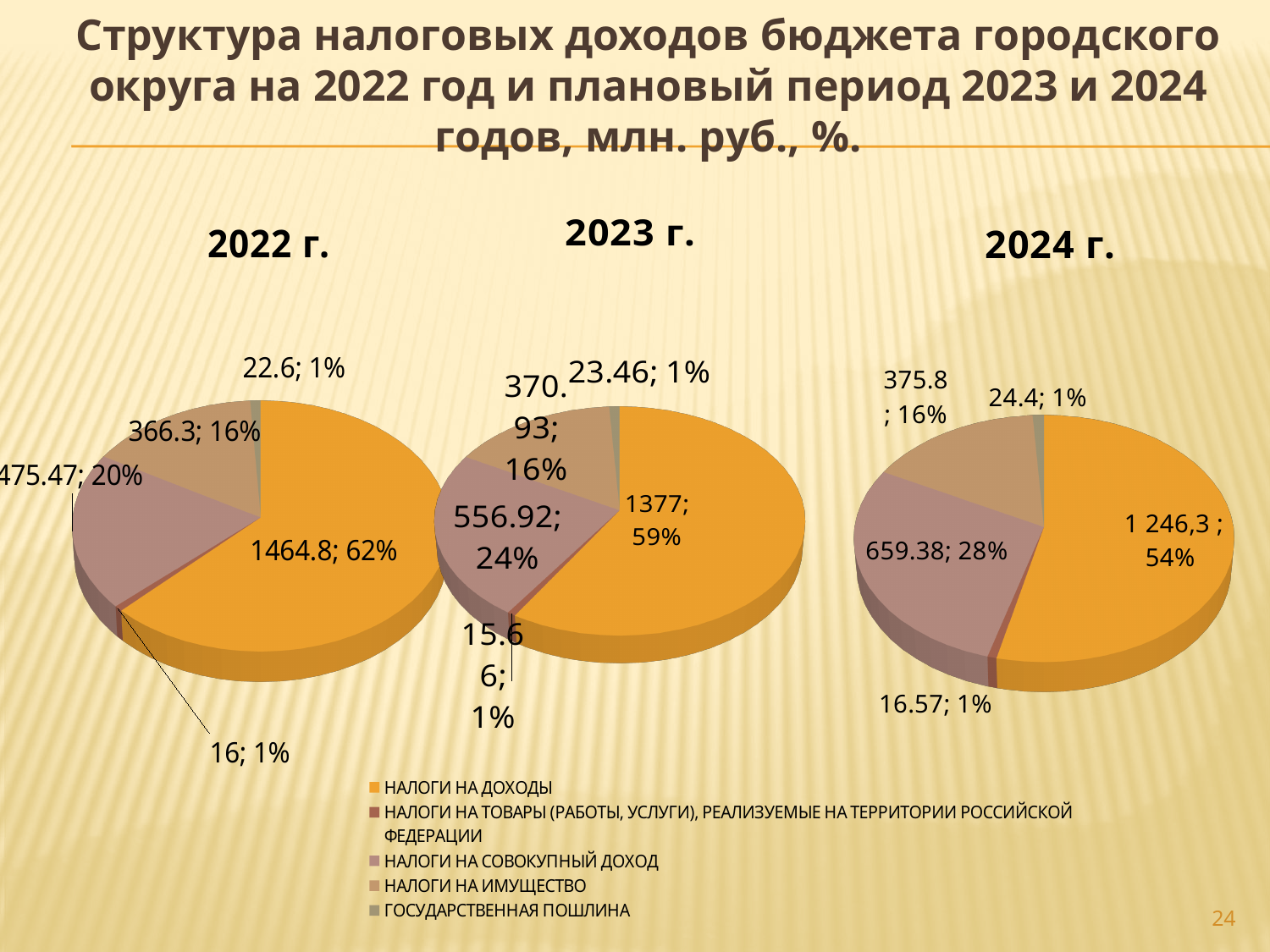
In the 2024 г. chart, what share of the pie is НАЛОГИ НА ДОХОДЫ? 54% What kind of charts are shown on the slide? Pie charts In the 2022 г. chart, what is the value for НАЛОГИ НА ДОХОДЫ? 1464.8; 62% In the 2022 г. chart, which category has the smallest value? НАЛОГИ НА ТОВАРЫ (РАБОТЫ, УСЛУГИ), РЕАЛИЗУЕМЫЕ НА ТЕРРИТОРИИ РОССИЙСКОЙ ФЕДЕРАЦИИ What is the difference between the НАЛОГИ НА ИМУЩЕСТВО value in the 2024 г. chart and in the 2022 г. chart? 9.5 In the 2024 г. chart, which category has the largest slice? НАЛОГИ НА ДОХОДЫ In the 2023 г. chart, what share of the pie is НАЛОГИ НА СОВОКУПНЫЙ ДОХОД? 24% In the 2024 г. chart, what is the value for НАЛОГИ НА ИМУЩЕСТВО? 375.8; 16% In the 2023 г. chart, what is the value for ГОСУДАРСТВЕННАЯ ПОШЛИНА? 23.46; 1% How many slices does each pie chart have? 5 How many series does the legend list? 5 In the 2023 г. chart, which is larger: НАЛОГИ НА СОВОКУПНЫЙ ДОХОД or НАЛОГИ НА ИМУЩЕСТВО? НАЛОГИ НА СОВОКУПНЫЙ ДОХОД